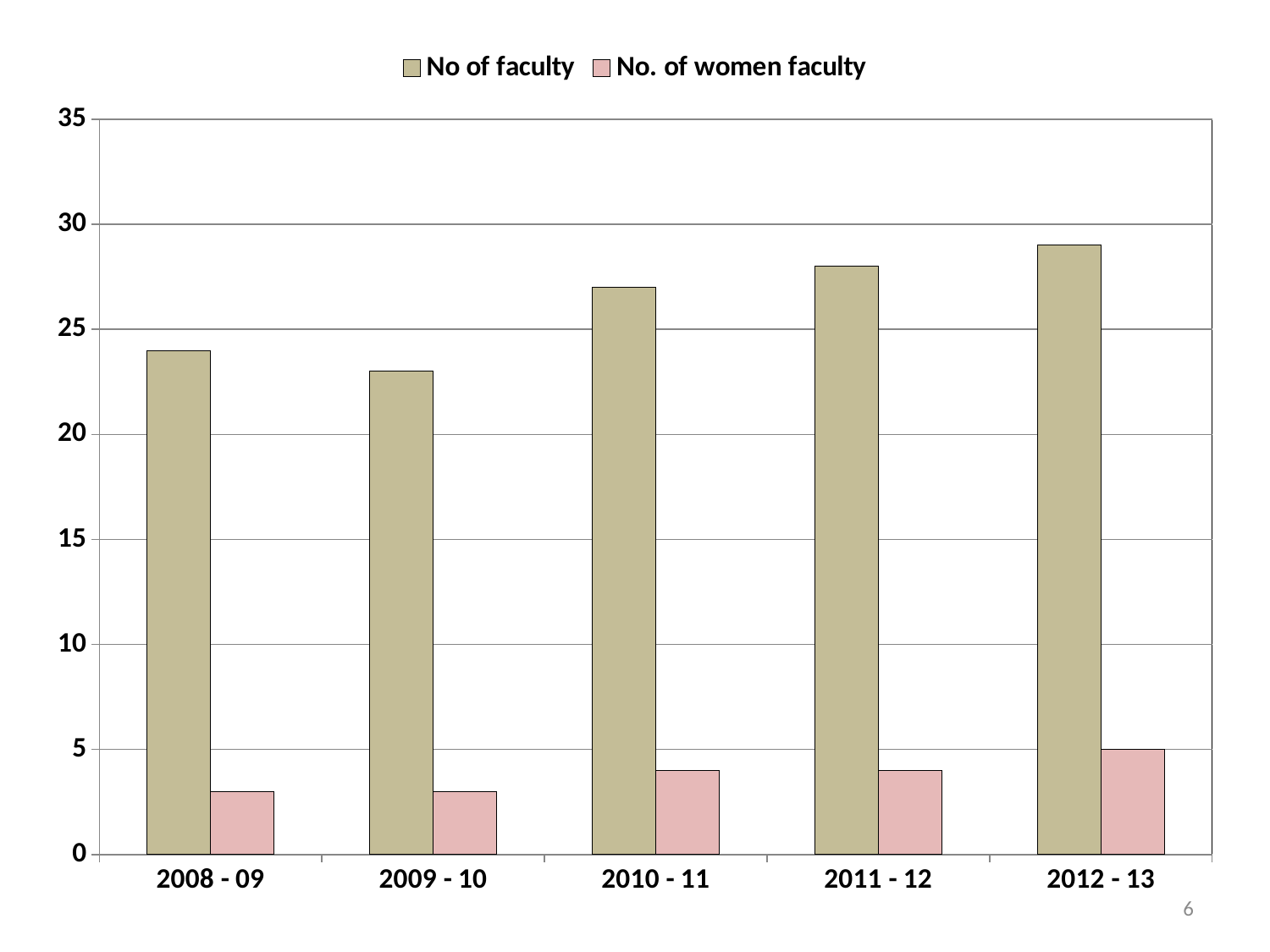
Is the value for No. of women faculty in 2008 - 09 greater or less than 5? less Does the No of faculty series generally rise or fall from 2009 - 10 to 2012 - 13? rise What type of chart is shown on the slide? bar chart What colour are the bars for No. of women faculty? pink How many series does the legend list? 2 Is the value for No of faculty in 2012 - 13 greater or less than 30? less Is the value for No of faculty in 2010 - 11 greater or less than 25? greater Which year has the highest value for No of faculty? 2012 - 13 Which year has the lowest value for No of faculty? 2009 - 10 Which is larger, No of faculty in 2011 - 12 or No of faculty in 2009 - 10? 2011 - 12 How many academic years are shown on the x axis? 5